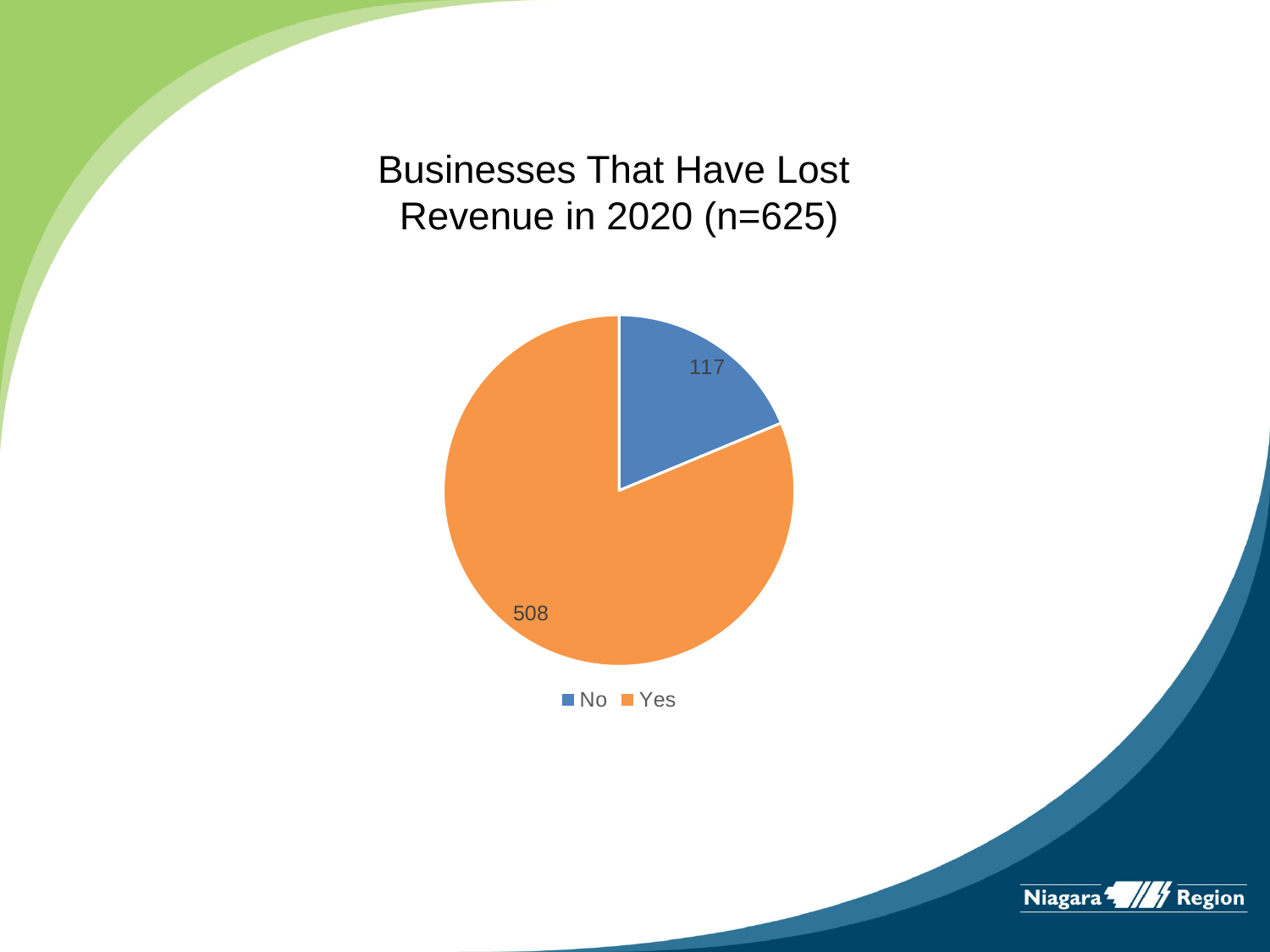
What is the difference between the "Yes" and "No" values? 391 Which category has the largest slice of the pie? Yes What colour is the "No" slice in the pie chart? Blue What kind of chart is shown on the slide? Pie chart What share of the pie does the "Yes" slice represent? 81.28% How many categories does the pie chart have? 2 What is the value for the "Yes" slice? 508 Which is larger, the value for "Yes" or the value for "No"? Yes What is the value for the "No" slice? 117 Which category has the smallest slice of the pie? No What is the title of the chart? Businesses That Have Lost Revenue in 2020 (n=625) What is the total of the two slices in the pie chart? 625